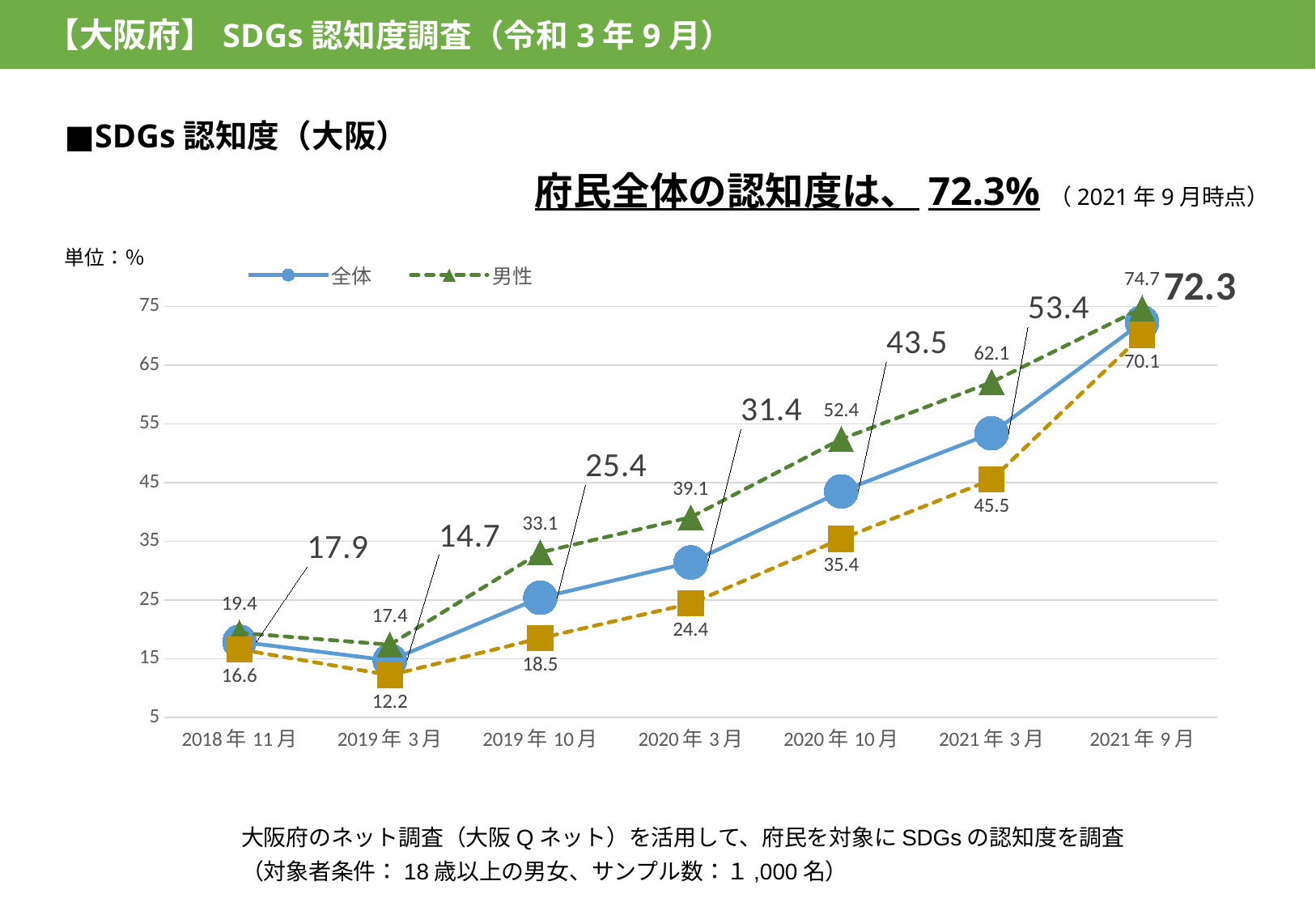
At 2020年3月, which is larger: the 全体 value or the 男性 value? 男性 What is the value of the 全体 series at 2019年3月? 14.7 By how much did the 全体 value increase from 2021年3月 to 2021年9月? 18.9 What kind of chart is shown on the slide? line chart At which survey date is the 男性 series highest? 2021年9月 At 2021年3月, how much higher is the 男性 value than the 全体 value? 8.7 Is the 男性 value at 2019年10月 greater or less than 25? greater What is the value of the 男性 series at 2020年10月? 52.4 What is the value of the 全体 series at 2021年9月? 72.3 How many survey dates are shown on the x axis? 7 Does the 全体 series rise or fall from 2019年3月 to 2021年9月? rise At which survey date is the 全体 series lowest? 2019年3月